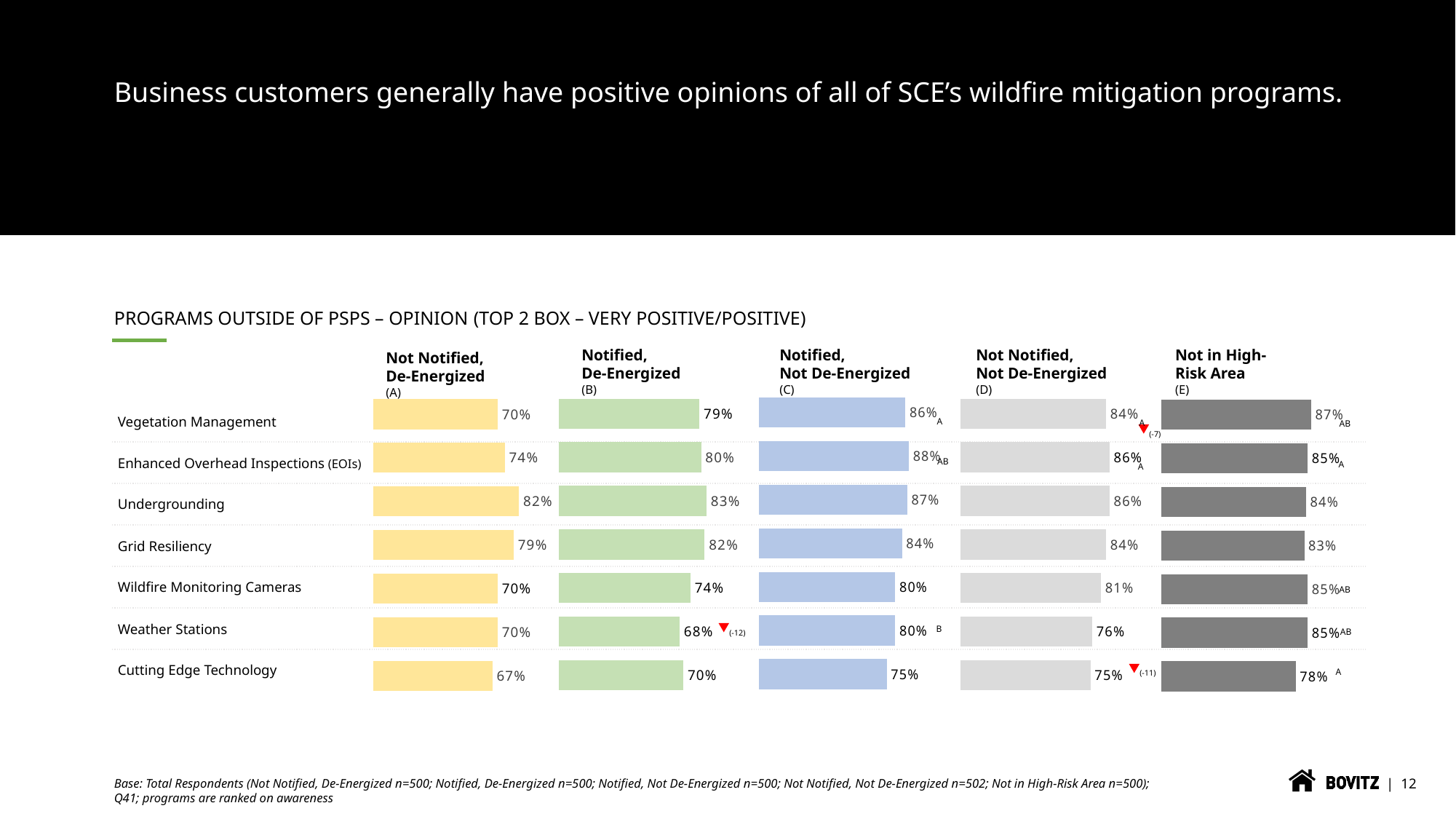
In the Not Notified, Not De-Energized chart, what is the value for Cutting Edge Technology? 75% In the Notified, De-Energized chart, what is the value for Weather Stations? 68% In the Not in High-Risk Area chart, which program has the lowest value? Cutting Edge Technology In the Not Notified, De-Energized chart, what is the value for Undergrounding? 82% For Grid Resiliency, which is larger: the value in the Notified, De-Energized chart or the value in the Not Notified, Not De-Energized chart? Not Notified, Not De-Energized In the Not Notified, De-Energized chart, which program has the highest value? Undergrounding In the Notified, Not De-Energized chart, which program has the highest value? Enhanced Overhead Inspections (EOIs) In the Notified, De-Energized chart, which program has the lowest value? Weather Stations How many programs are listed in each chart? 7 How many customer segment charts are shown on the slide? 5 What is the difference between the Vegetation Management value in the Not in High-Risk Area chart and in the Not Notified, De-Energized chart? 17 percentage points What kind of chart is used to show the opinion values on this slide? Bar chart